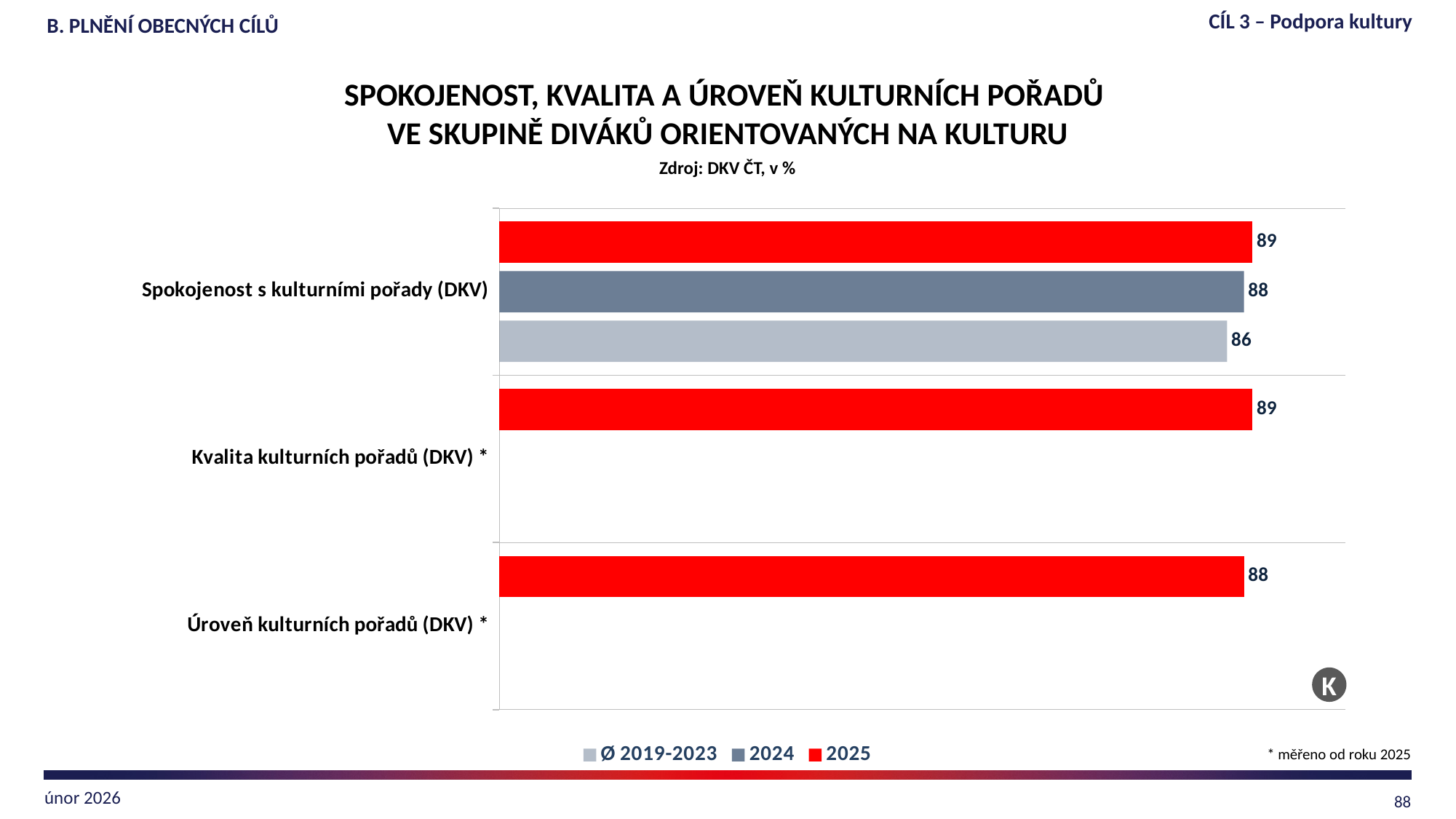
What is the difference between the 2025 and Ø 2019-2023 values for Spokojenost s kulturními pořady (DKV)? 3 Which series is shown in red in the legend? 2025 What kind of chart is shown on the slide? Bar chart What is the 2024 value for Spokojenost s kulturními pořady (DKV)? 88 What is the Ø 2019-2023 value for Spokojenost s kulturními pořady (DKV)? 86 How many series does the legend list? 3 How many categories are shown on the chart? 3 What is the 2025 value for Úroveň kulturních pořadů (DKV)? 88 What is the 2025 value for Spokojenost s kulturními pořady (DKV)? 89 Which is larger for Spokojenost s kulturními pořady (DKV): the 2024 value or the Ø 2019-2023 value? 2024 Which category has the lowest Ø 2019-2023 value shown? Spokojenost s kulturními pořady (DKV) What is the 2025 value for Kvalita kulturních pořadů (DKV)? 89